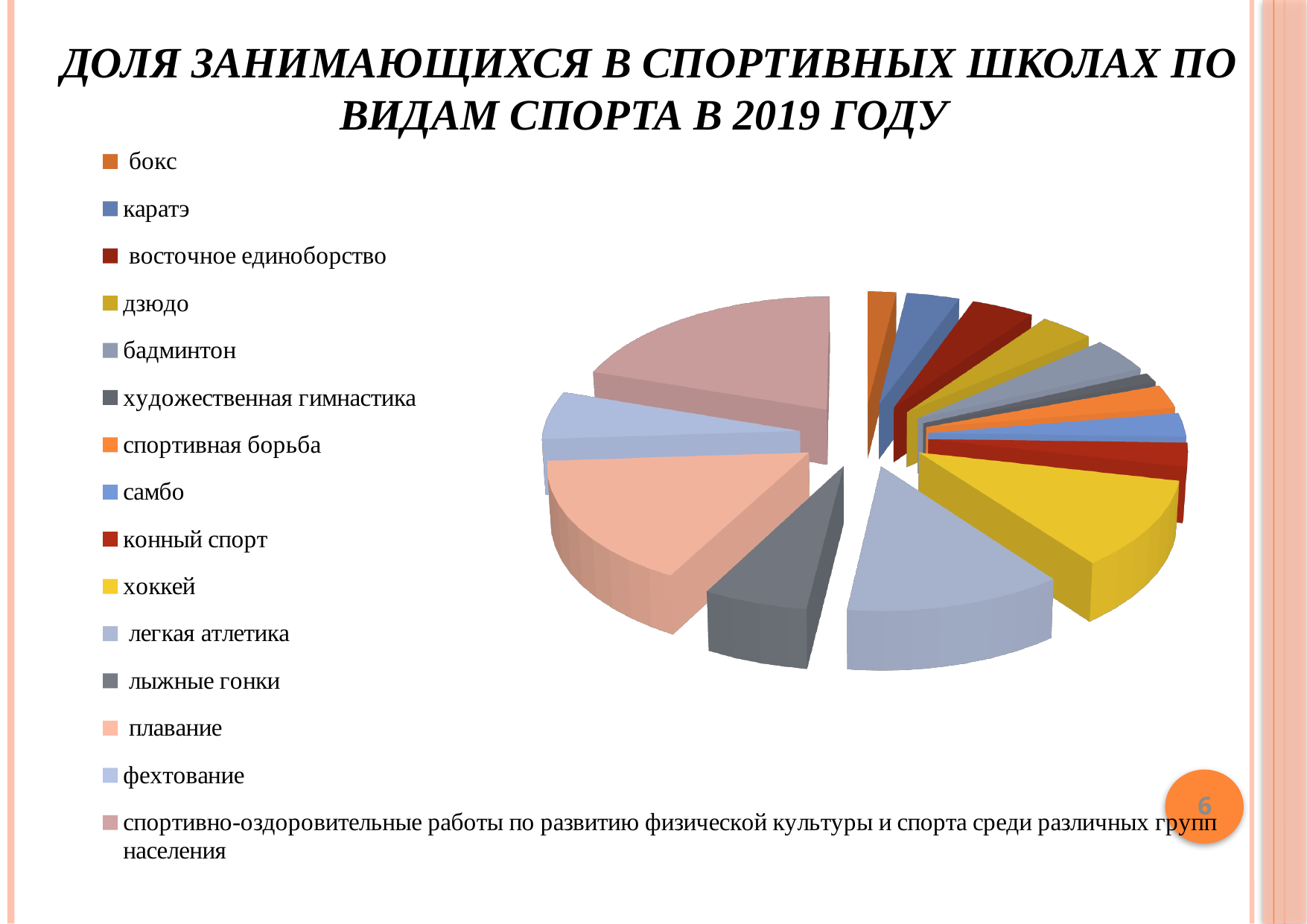
What is the title of the chart on the slide? ДОЛЯ ЗАНИМАЮЩИХСЯ В СПОРТИВНЫХ ШКОЛАХ ПО ВИДАМ СПОРТА В 2019 ГОДУ Which slice is larger in the pie chart: лыжные гонки or самбо? лыжные гонки Which slice is larger in the pie chart: хоккей or бокс? хоккей Which slice is larger in the pie chart: фехтование or художественная гимнастика? фехтование Which category is listed first in the legend of the pie chart? бокс How many categories (sports) does the legend of the pie chart list? 15 What kind of chart is shown on the slide? pie chart